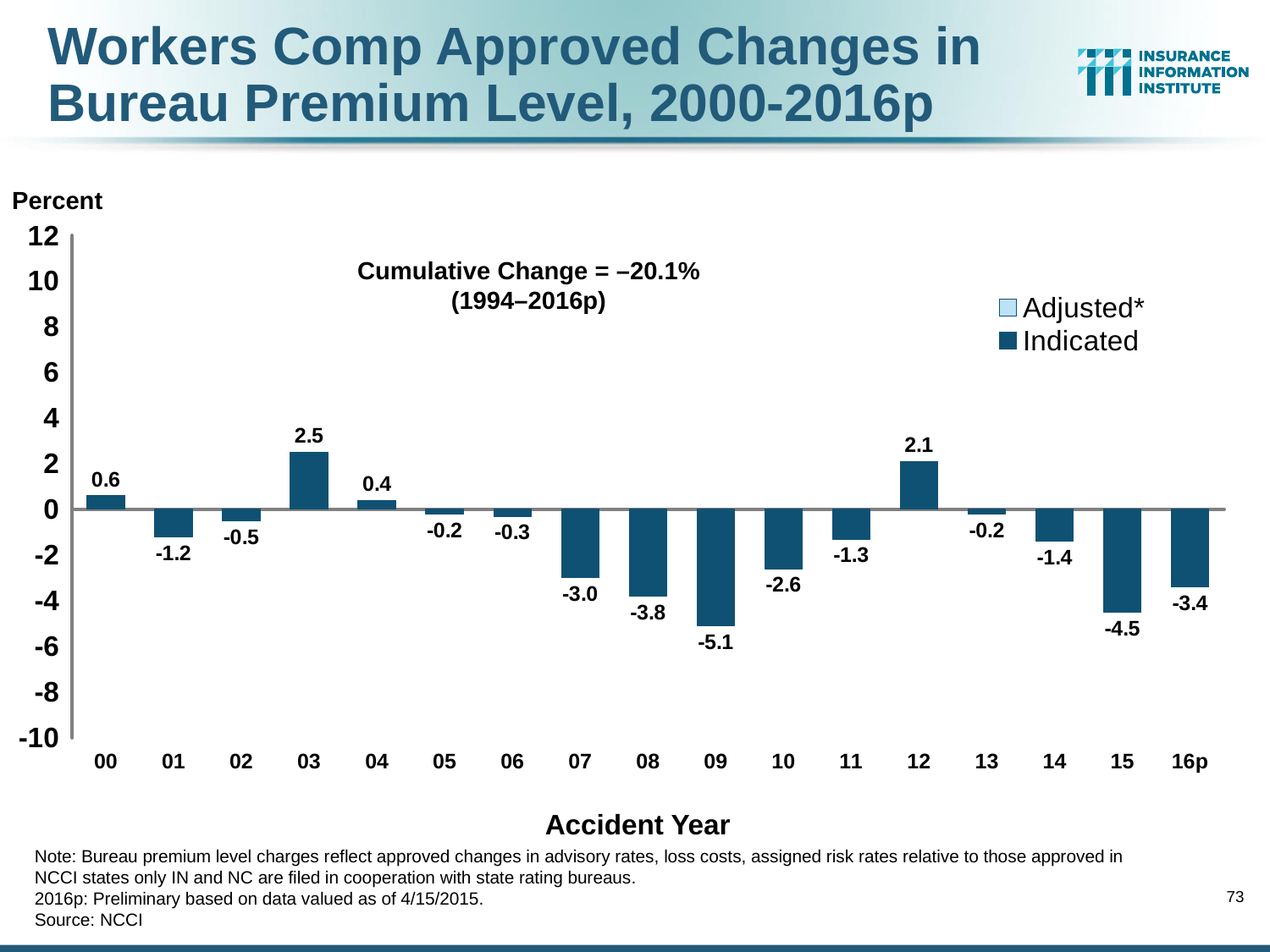
Which is larger, the value for accident year 08 or accident year 15? 08 What is the value for accident year 03? 2.5 What is the value for accident year 09? -5.1 How many accident years are shown on the x axis? 17 What is the difference between the values for accident years 03 and 12? 0.4 How many series does the legend list? 2 Is the value for accident year 15 greater or less than -4? less What is the value for accident year 16p? -3.4 What kind of chart is shown on the slide? bar chart Which accident year has the highest value? 03 Which accident year has the lowest value? 09 What cumulative change is stated on the chart for 1994–2016p? –20.1%